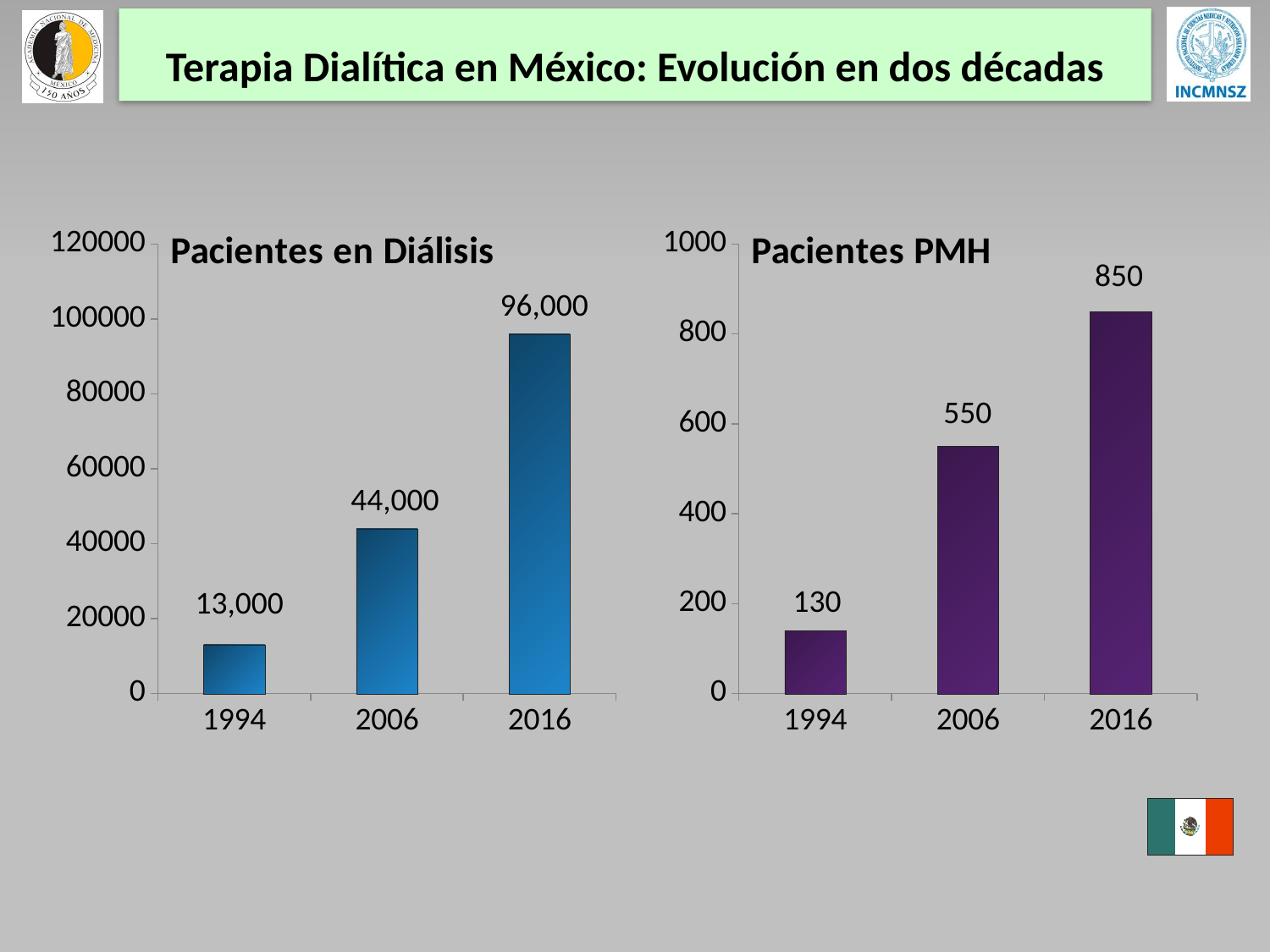
How many years are shown in the 'Pacientes PMH' chart? 3 In the 'Pacientes en Diálisis' chart, which year has the highest value? 2016 In the 'Pacientes PMH' chart, do the values rise or fall from 1994 to 2016? rise In the 'Pacientes en Diálisis' chart, is the value for 2016 greater or less than 80000? greater In the 'Pacientes PMH' chart, which year has the lowest value? 1994 In the 'Pacientes PMH' chart, which is larger, the value for 2006 or the value for 1994? 2006 What kind of chart is the 'Pacientes en Diálisis' chart? bar chart In the 'Pacientes en Diálisis' chart, what is the value for 2006? 44,000 In the 'Pacientes PMH' chart, what is the value for 1994? 130 What is the title of the chart on the right side of the slide? Pacientes PMH In the 'Pacientes en Diálisis' chart, what is the difference between the 2016 and 1994 values? 83,000 In the 'Pacientes PMH' chart, what is the difference between the 2016 and 2006 values? 300